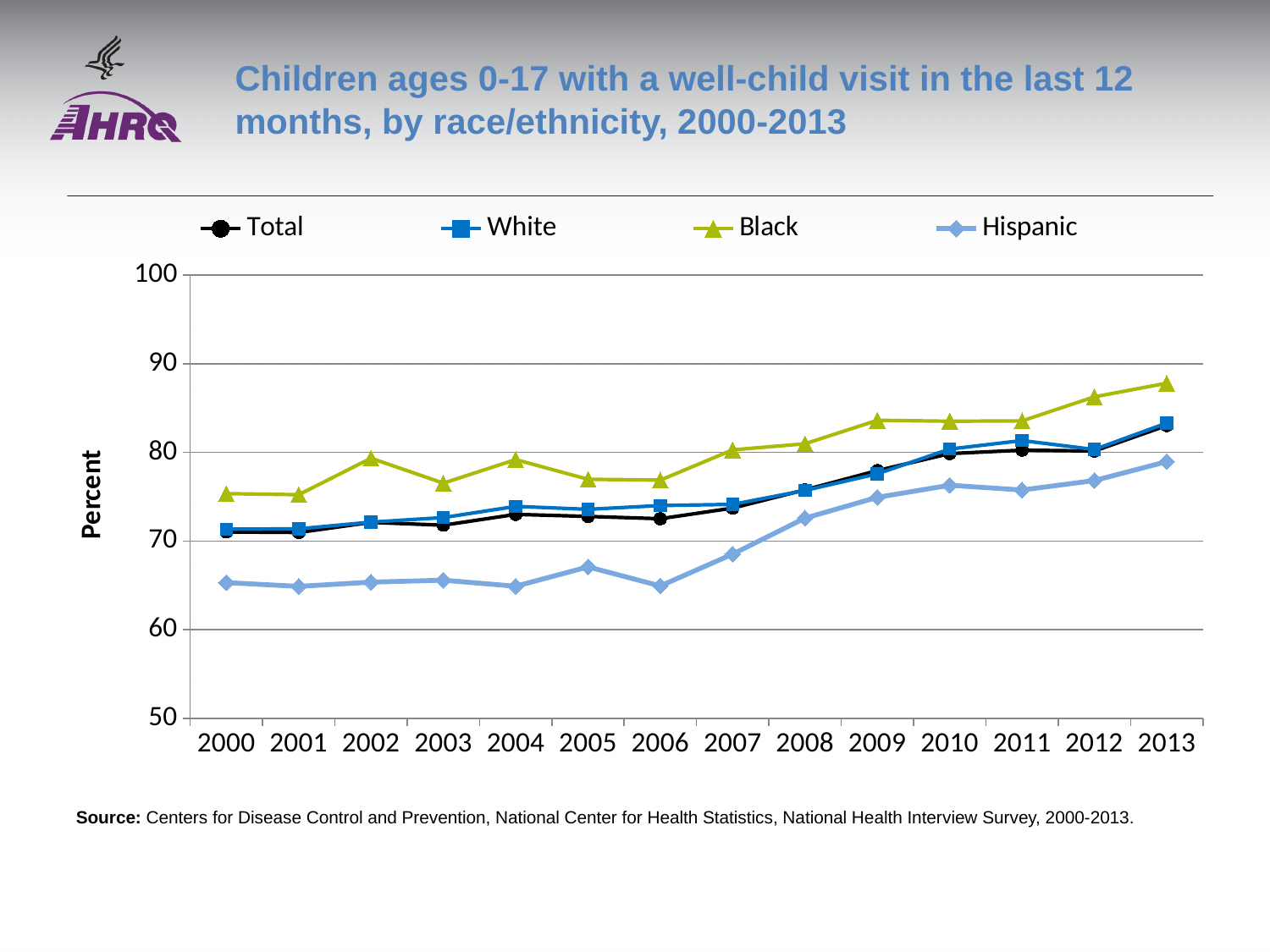
Does the Hispanic series rise or fall from 2000 to 2013? rise Is the value for Black in 2000 greater or less than 80? less In which year does the Black series reach its highest value? 2013 What is the label on the y axis? Percent Is the value for Black in 2013 greater or less than 80? greater Which is larger in 2005, the value for Black or the value for Hispanic? Black Is the value for Hispanic in 2000 greater or less than 70? less How many years are shown on the x axis? 14 Which series has the highest value in 2013? Black What kind of chart is shown on the slide? line chart How many series does the legend list? 4 Which series has the lowest value in 2013? Hispanic